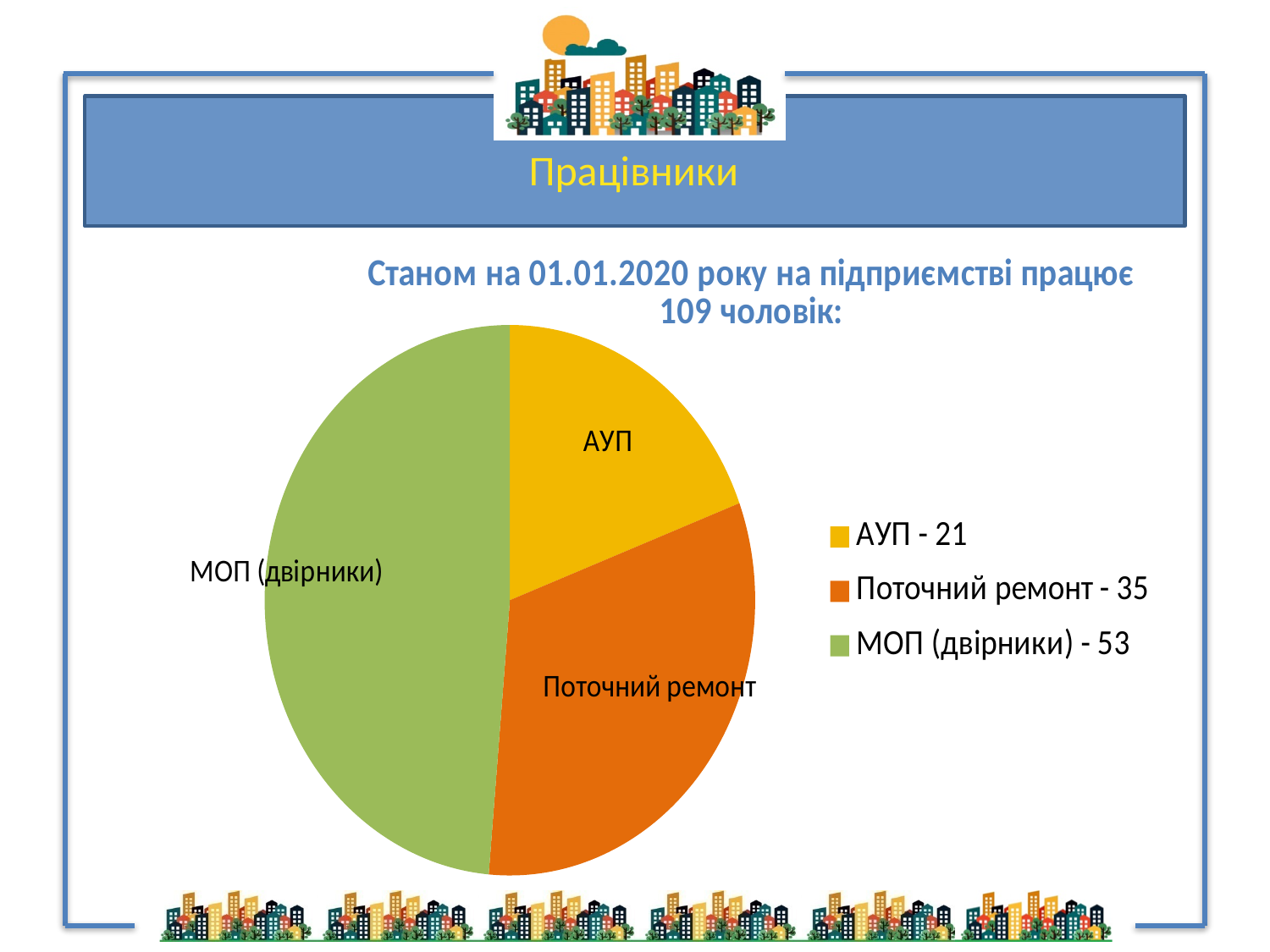
Which is larger, Поточний ремонт or АУП? Поточний ремонт How many slices does the pie chart have? 3 According to the legend, how many employees are in МОП (двірники)? 53 According to the legend, how many employees are in АУП? 21 Which category has the smallest slice of the pie? АУП Which category has the largest slice of the pie? МОП (двірники) According to the legend, how many employees are in Поточний ремонт? 35 What is the total number of employees shown across all three categories? 109 What type of chart is shown on the slide? pie chart What is the difference between the number of employees in МОП (двірники) and in АУП? 32 What is the difference between the number of employees in Поточний ремонт and in АУП? 14 What colour is the slice for Поточний ремонт? orange